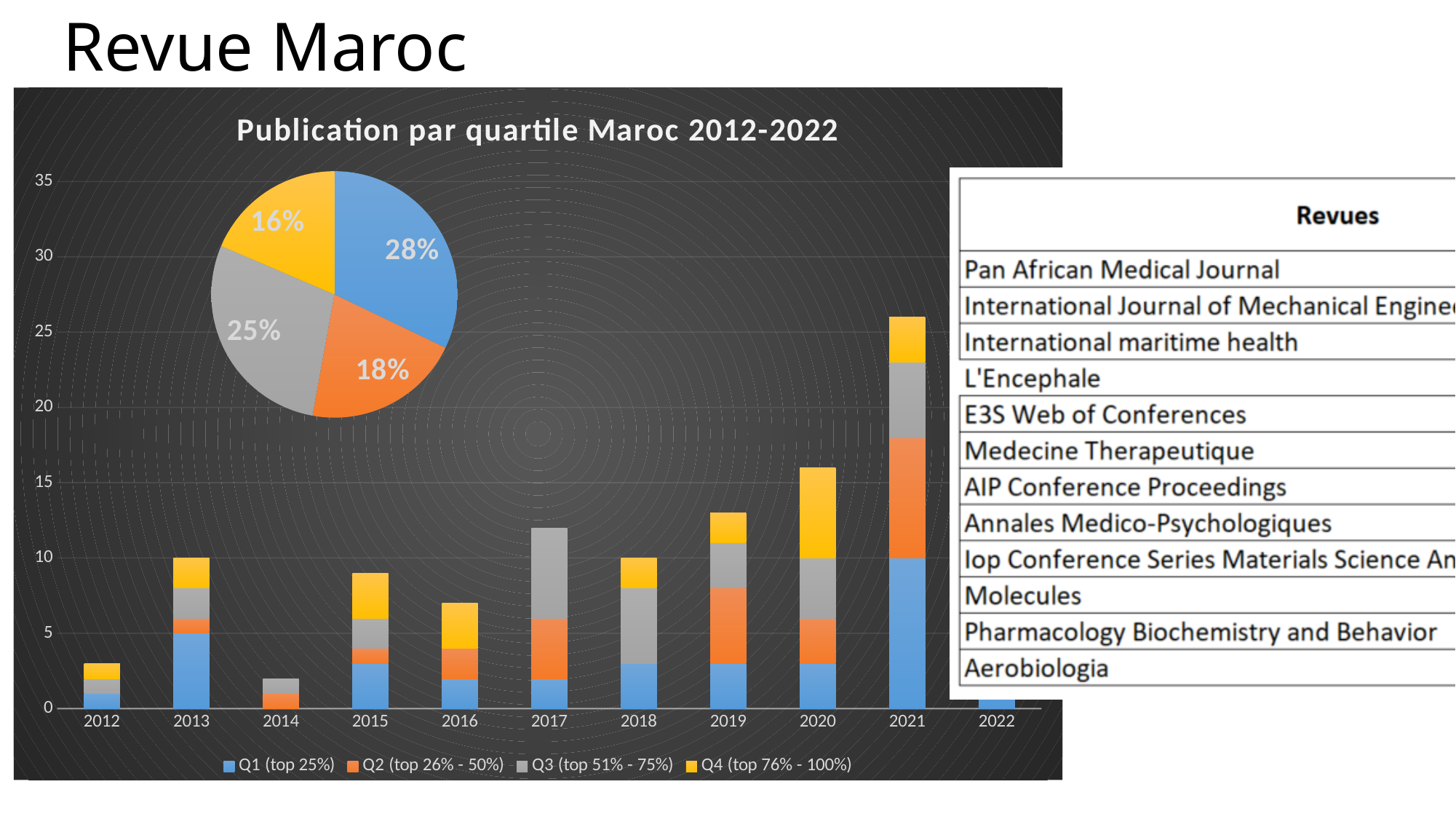
In the pie chart, which quartile has the smallest share? Q4 (top 76% - 100%) How many years are shown on the x axis of the bar chart? 11 How many series does the legend of the bar chart list? 4 In the stacked bar chart, is the total for 2021 greater or less than 25? greater In the pie chart, which quartile has the largest share? Q1 (top 25%) In the stacked bar chart, is the total for 2014 greater or less than 5? less In the pie chart, what is the difference in percentage points between the Q1 slice and the Q2 slice? 10 In the pie chart, what percentage is shown for the orange slice (Q2)? 18% What is the title of the chart on the slide? Publication par quartile Maroc 2012-2022 In the pie chart, what percentage is shown for the grey slice (Q3)? 25% In the pie chart, what percentage is shown for the blue slice (Q1)? 28%